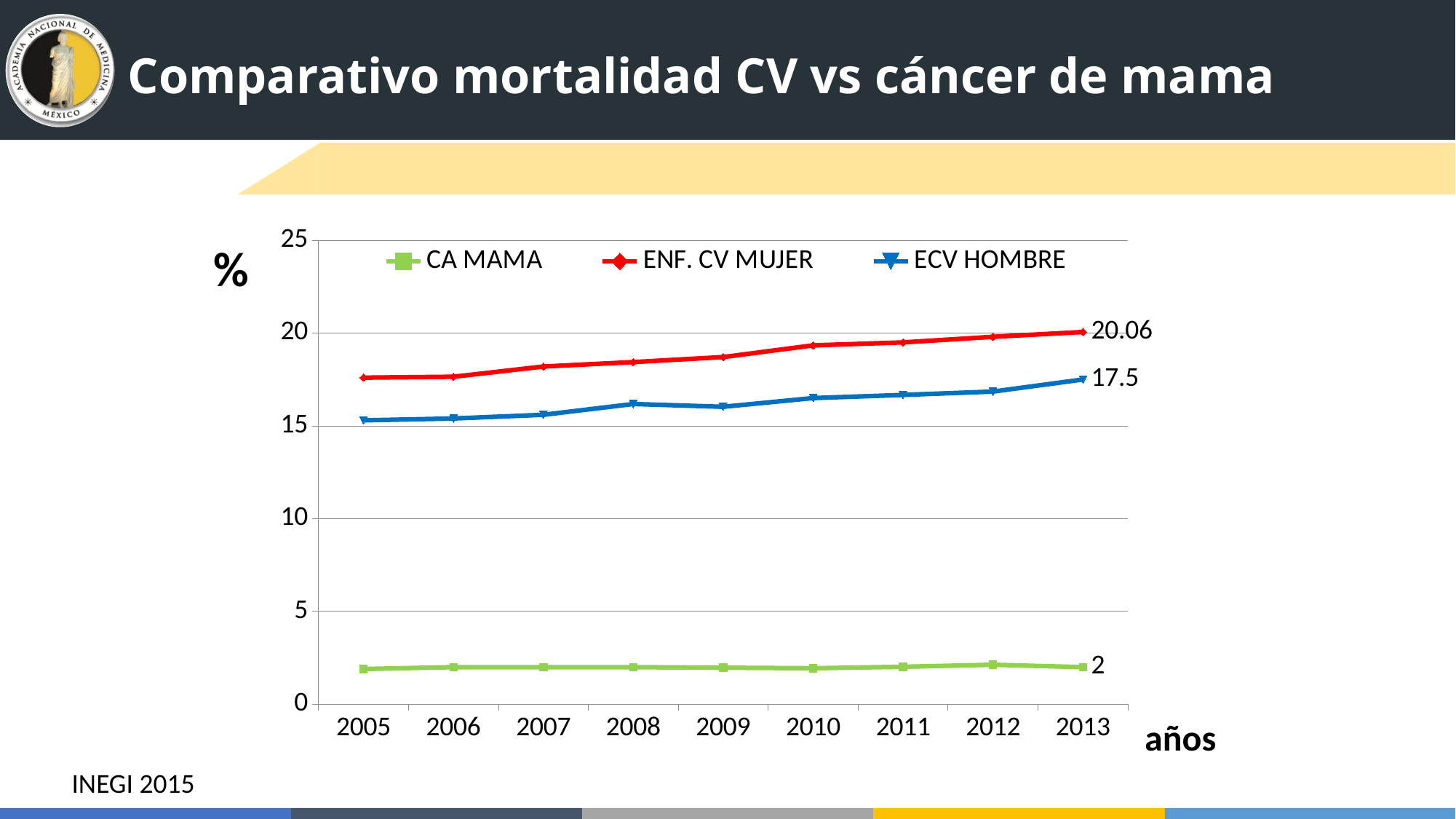
What is the difference between ENF. CV MUJER and ECV HOMBRE in 2013? 2.56 Is the value for ECV HOMBRE in 2005 greater or less than 20? less How many series does the legend list? 3 Which series has the lowest values across all years? CA MAMA What type of chart is shown on the slide? line chart Which series has the highest value in 2013? ENF. CV MUJER What is the value for ECV HOMBRE in 2013? 17.5 Which series is drawn in red? ENF. CV MUJER Does the ENF. CV MUJER series rise or fall from 2005 to 2013? rise How many years are shown on the x axis? 9 What is the value for CA MAMA in 2013? 2 What is the value for ENF. CV MUJER in 2013? 20.06